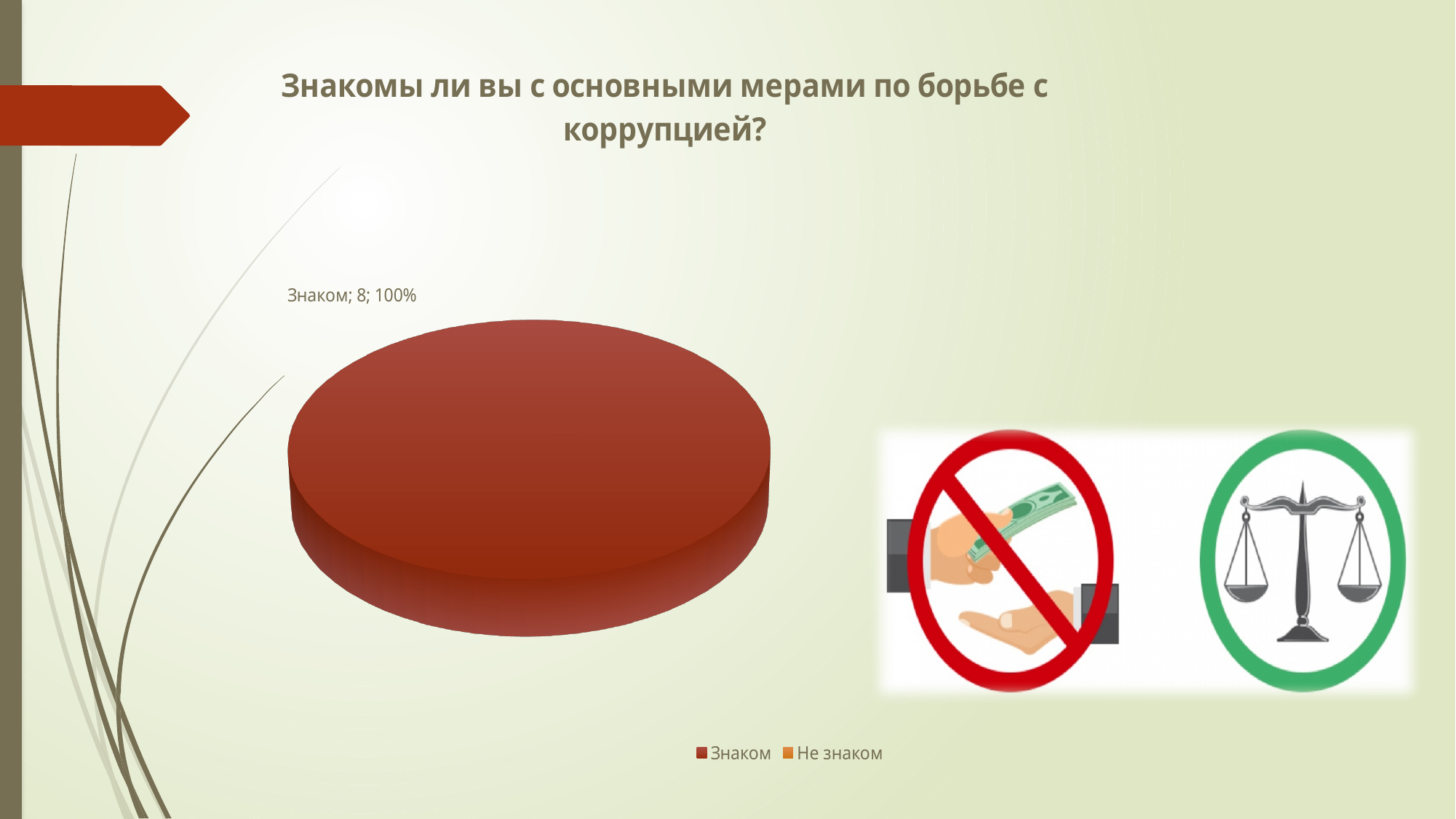
What colour is the "Знаком" slice in the pie chart? dark red How many entries does the legend list? 2 Which category is larger in the pie chart, "Знаком" or "Не знаком"? Знаком Which category has the largest share of the pie? Знаком What share of the pie does the "Знаком" slice represent? 100% What is the title of the chart? Знакомы ли вы с основными мерами по борьбе с коррупцией? What is the value shown for the "Знаком" slice? 8 What kind of chart is shown on the slide? pie chart